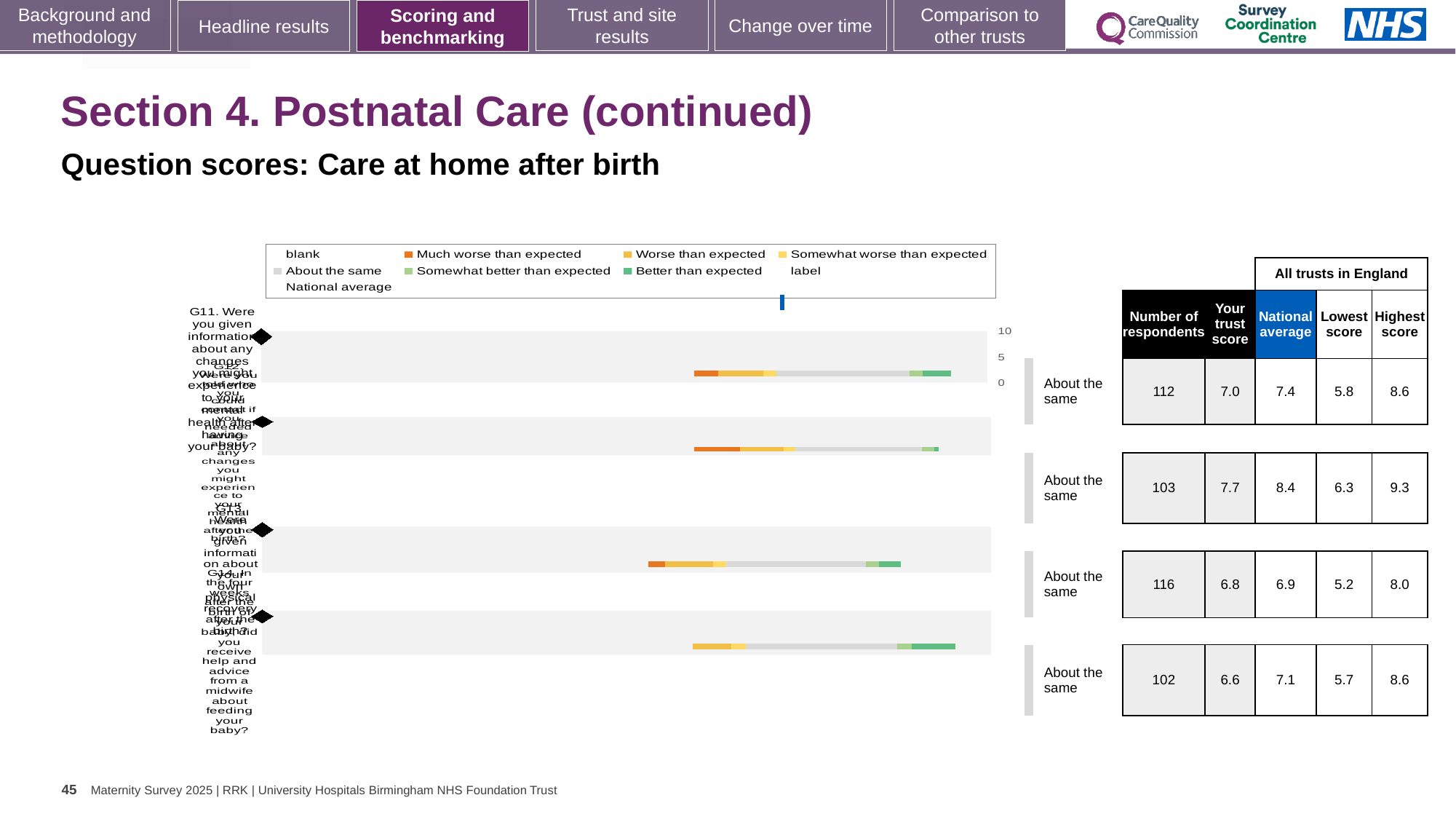
What is the highest tick value shown on the chart's axis? 10 In the table beside the chart, what is the 'Your trust score' for the first row? 7.0 How many entries does the chart legend list? 9 How many horizontal bars are plotted in the chart? 4 In the table beside the chart, what is the difference between the 'Highest score' and 'Lowest score' in the fourth row? 2.9 In the table beside the chart, is the 'Your trust score' in the second row larger or smaller than the 'National average' in that row? smaller In the table beside the chart, which row has the highest 'Number of respondents'? the third row (116) In the table beside the chart, what is the 'National average' for the second row? 8.4 What colour represents 'Much worse than expected' in the chart legend? orange What kind of chart is shown on the slide? bar chart What colour represents 'Better than expected' in the chart legend? green What benchmark label is shown next to each of the four bars in the chart? About the same